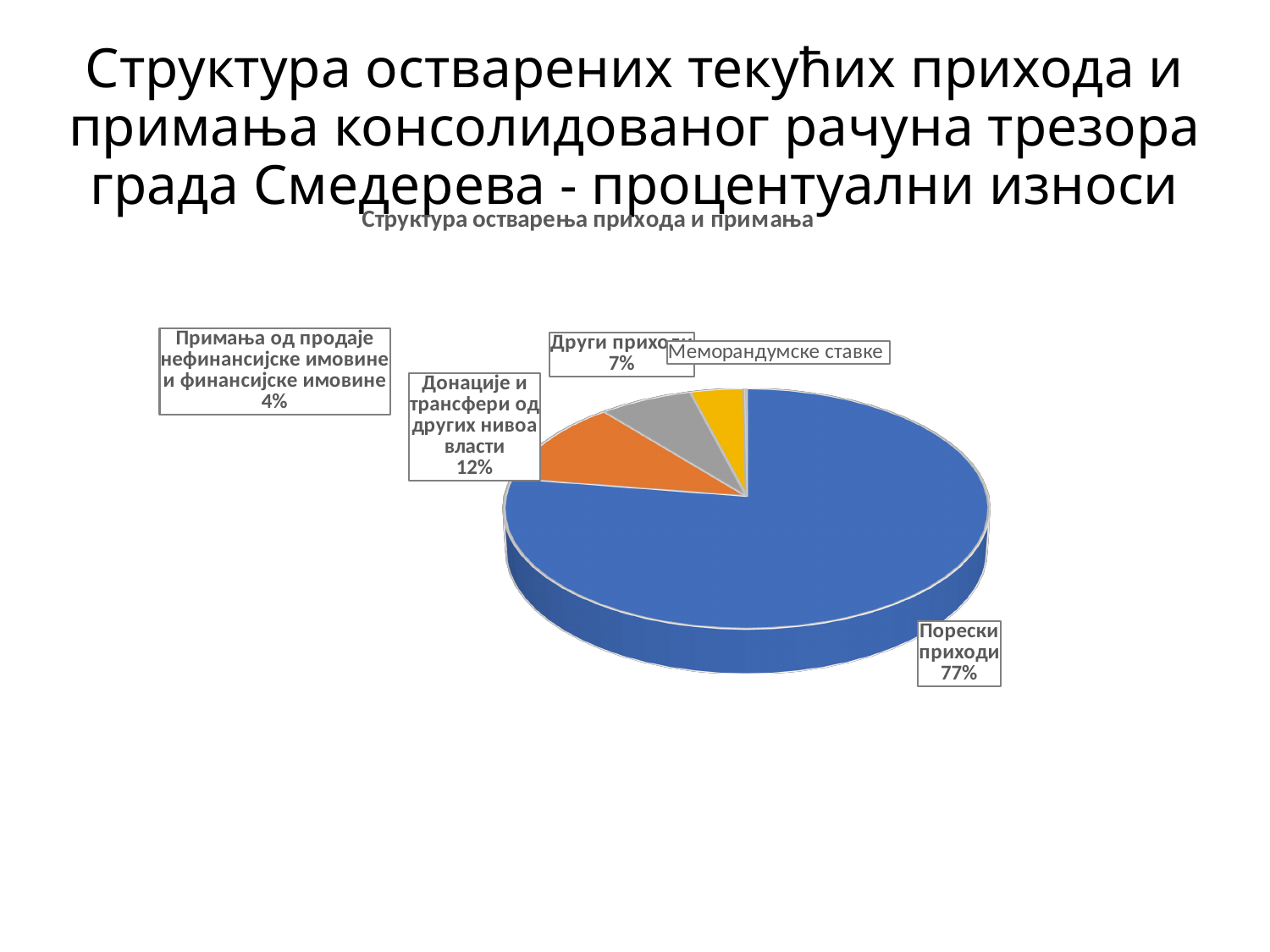
Which category has the largest share of the pie? Порески приходи What is the title of the chart? Структура остварења прихода и примања What kind of chart is shown on the slide? Pie chart What is the difference in percentage points between Порески приходи and Донације и трансфери од других нивоа власти? 65 What colour is the slice for Порески приходи? Blue What percentage is shown for Други приходи? 7% What percentage of the pie does Порески приходи represent? 77% What percentage is shown for Донације и трансфери од других нивоа власти? 12% Which category with a printed percentage has the smallest share of the pie? Примања од продаје нефинансијске имовине и финансијске имовине What percentage is shown for Примања од продаје нефинансијске имовине и финансијске имовине? 4% Which is larger, the share for Други приходи or the share for Примања од продаје нефинансијске имовине и финансијске имовине? Други приходи What is the difference in percentage points between Донације и трансфери од других нивоа власти and Други приходи? 5